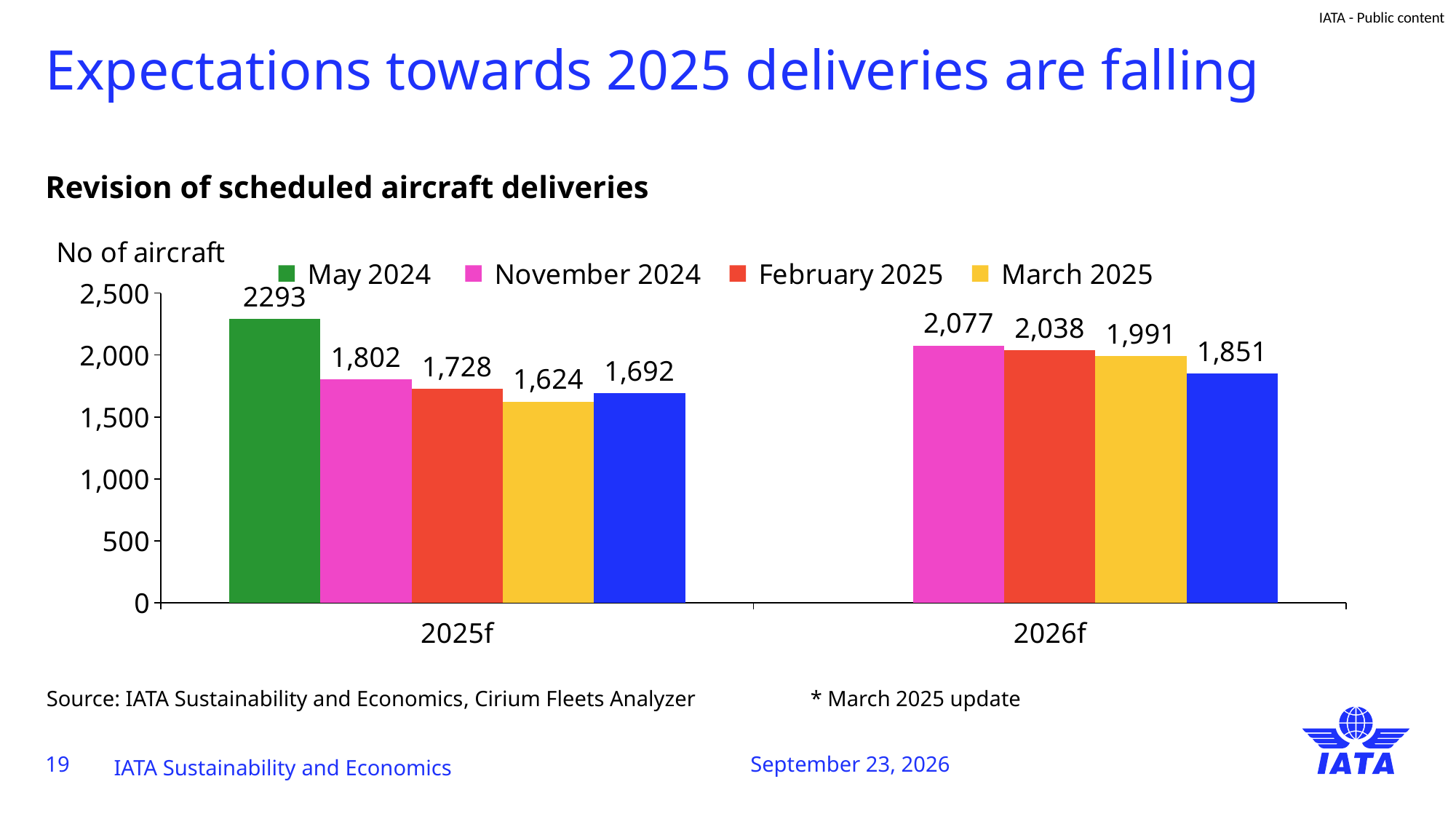
Which legend series has the lowest value for 2026f? March 2025 How many series does the legend list? 4 Which series has the highest value for 2025f? May 2024 What is the February 2025 value for 2026f? 2,038 What kind of chart is shown on the slide? Bar chart What is the May 2024 value for 2025f? 2293 What is the March 2025 value for 2025f? 1,624 What is the difference between the November 2024 and March 2025 values for 2026f? 86 What is the title of the chart? Revision of scheduled aircraft deliveries Is the February 2025 value larger for 2025f or 2026f? 2026f What is the difference between the May 2024 and November 2024 values for 2025f? 491 What is the November 2024 value for 2026f? 2,077